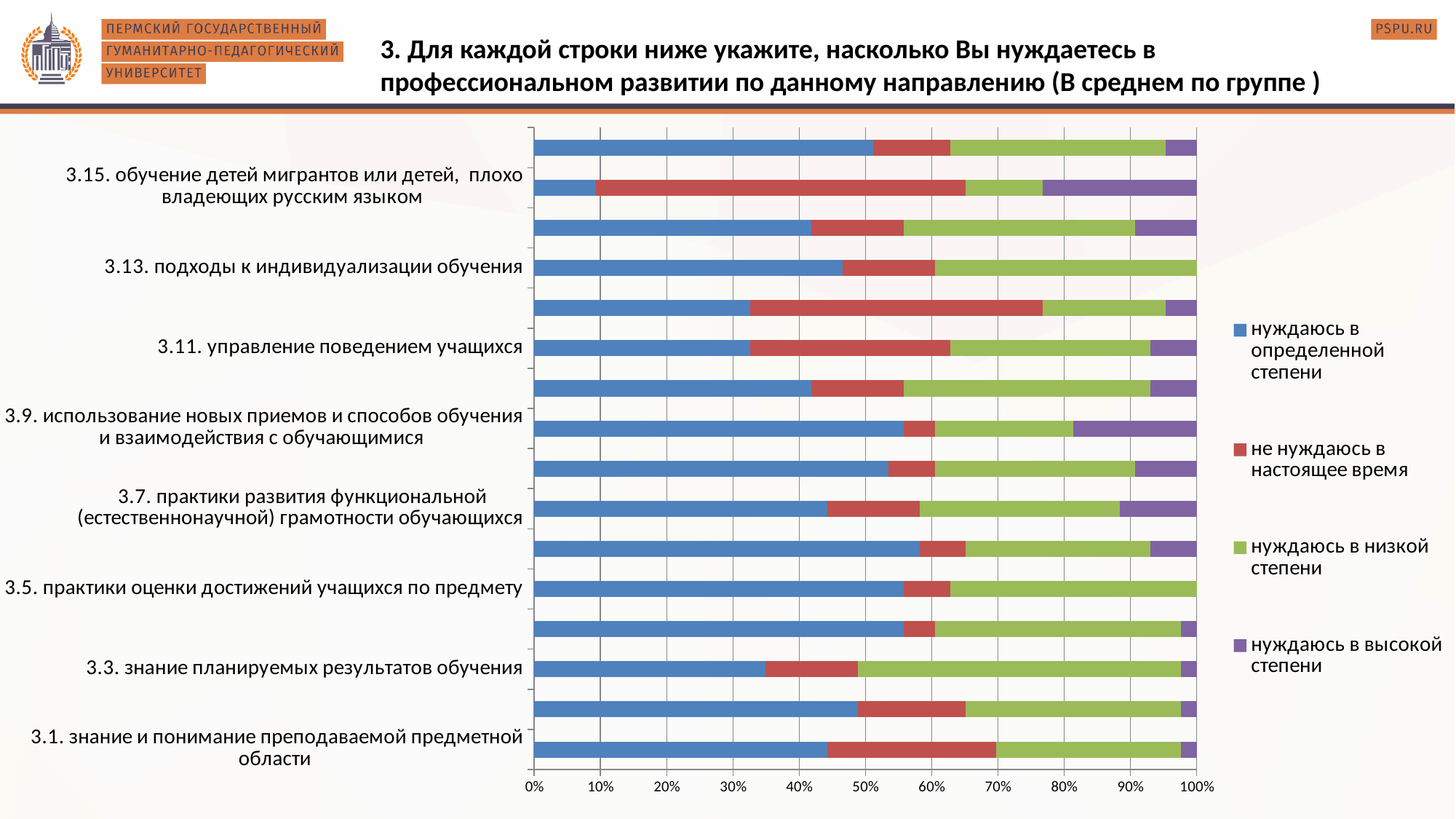
Which has the larger 'нуждаюсь в определенной степени' share: '3.1. знание и понимание преподаваемой предметной области' or '3.15. обучение детей мигрантов или детей, плохо владеющих русским языком'? 3.1. знание и понимание преподаваемой предметной области Is the value of 'нуждаюсь в определенной степени' for '3.5. практики оценки достижений учащихся по предмету' greater or less than 50%? greater Is the value of 'нуждаюсь в определенной степени' for '3.15. обучение детей мигрантов или детей, плохо владеющих русским языком' greater or less than 20%? less Is the value of 'нуждаюсь в определенной степени' for '3.11. управление поведением учащихся' greater or less than 40%? less Which legend entry is shown in blue? нуждаюсь в определенной степени How many bars are plotted in the chart? 16 Which has the larger 'нуждаюсь в определенной степени' share: '3.5. практики оценки достижений учащихся по предмету' or '3.11. управление поведением учащихся'? 3.5. практики оценки достижений учащихся по предмету Which legend entry is shown in purple? нуждаюсь в высокой степени What kind of chart is shown on the slide? Stacked bar chart How many series does the legend list? 4